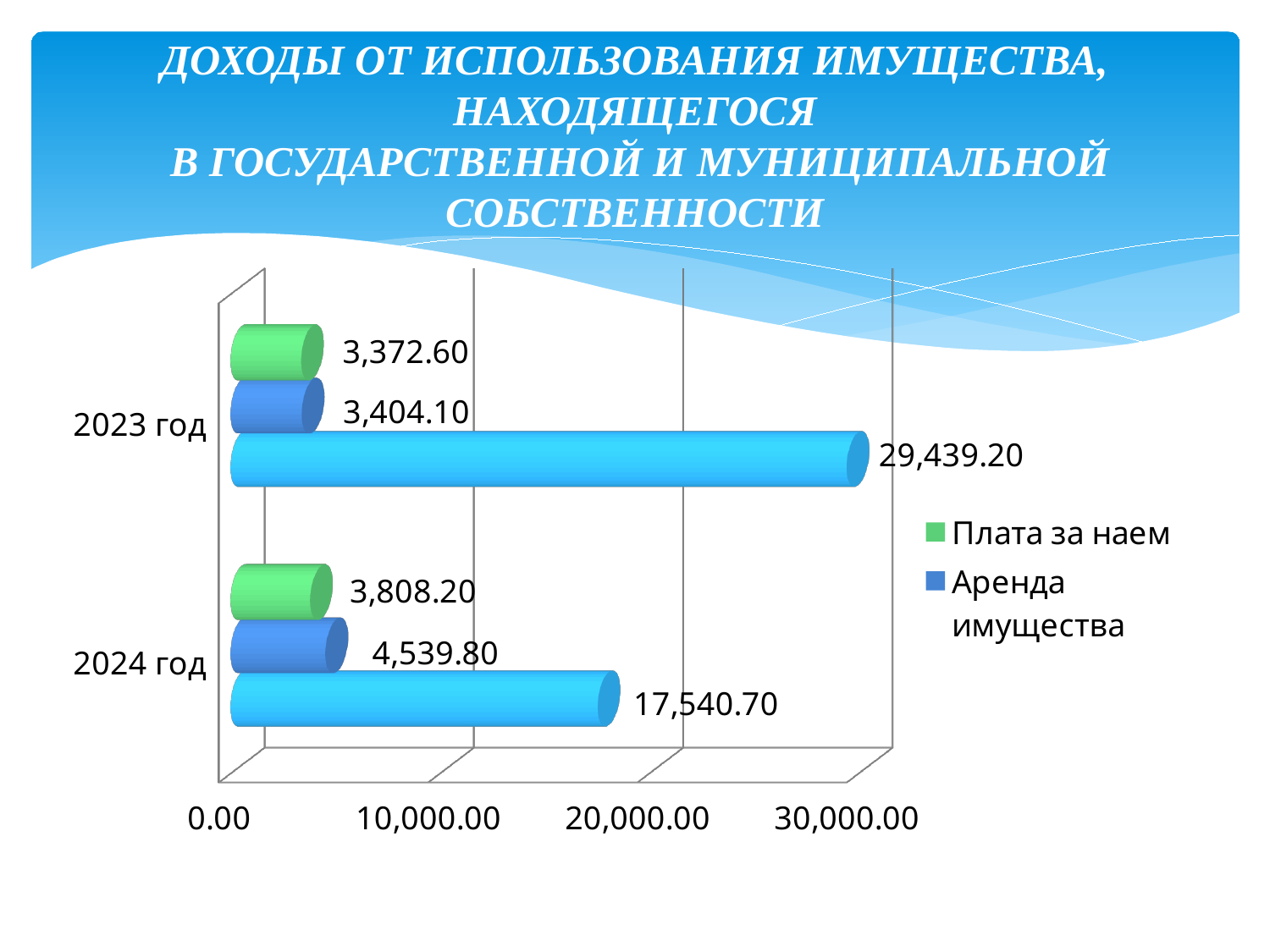
What is the value of Аренда имущества for 2023 год? 3,404.10 What is the value of Аренда имущества for 2024 год? 4,539.80 What is the difference between Плата за наем in 2024 год and in 2023 год? 435.60 By how much did Аренда имущества increase from 2023 год to 2024 год? 1,135.70 What kind of chart is shown on the slide? Bar chart Does Плата за наем rise or fall from 2023 год to 2024 год? Rises In 2024 год, which is larger: Плата за наем or Аренда имущества? Аренда имущества Is the value of the longest bar for 2024 год greater or less than 20,000.00? less What is the value of Плата за наем for 2024 год? 3,808.20 How many year categories are shown on the chart? 2 How many series does the legend list? 2 What is the value of Плата за наем for 2023 год? 3,372.60